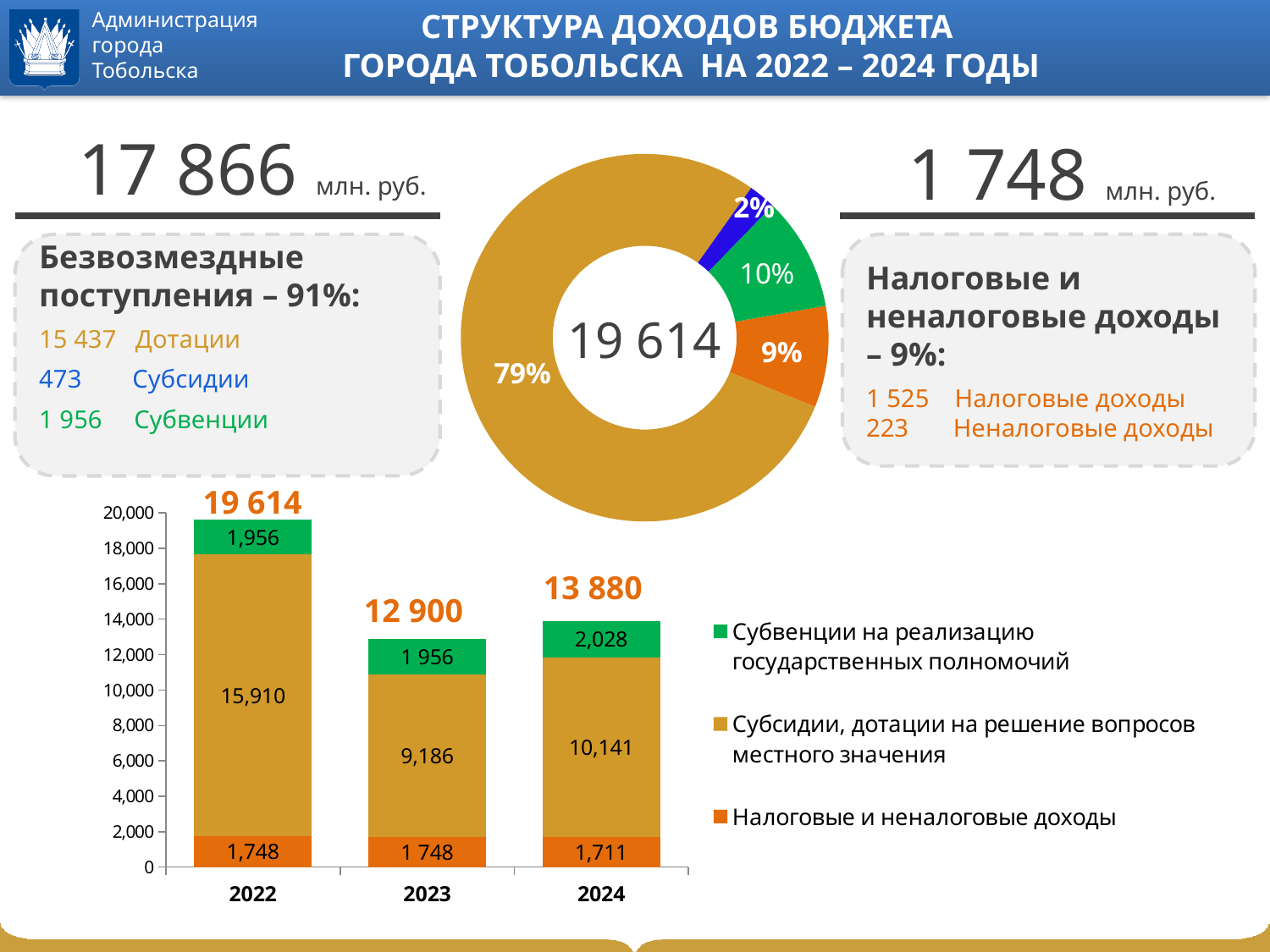
How many years are shown on the x axis of the stacked bar chart? 3 In the stacked bar chart, which year has the highest total? 2022 In the stacked bar chart, which year has the lowest total? 2023 How many series does the legend of the stacked bar chart list? 3 What kind of chart is the chart at the bottom left of the slide? bar chart In the stacked bar chart, what is the value of 'Налоговые и неналоговые доходы' for 2023? 1 748 In the donut chart, what is the share of the largest slice? 79% In the stacked bar chart, what is the difference between the totals for 2024 and 2023? 980 In the stacked bar chart, is the total for 2022 greater or less than 18,000? greater In the stacked bar chart, which is larger: 'Субвенции на реализацию государственных полномочий' in 2024 or in 2022? 2024 In the stacked bar chart, what is the total of the bar for 2023? 12 900 In the stacked bar chart, what is the value of 'Субсидии, дотации на решение вопросов местного значения' for 2024? 10,141